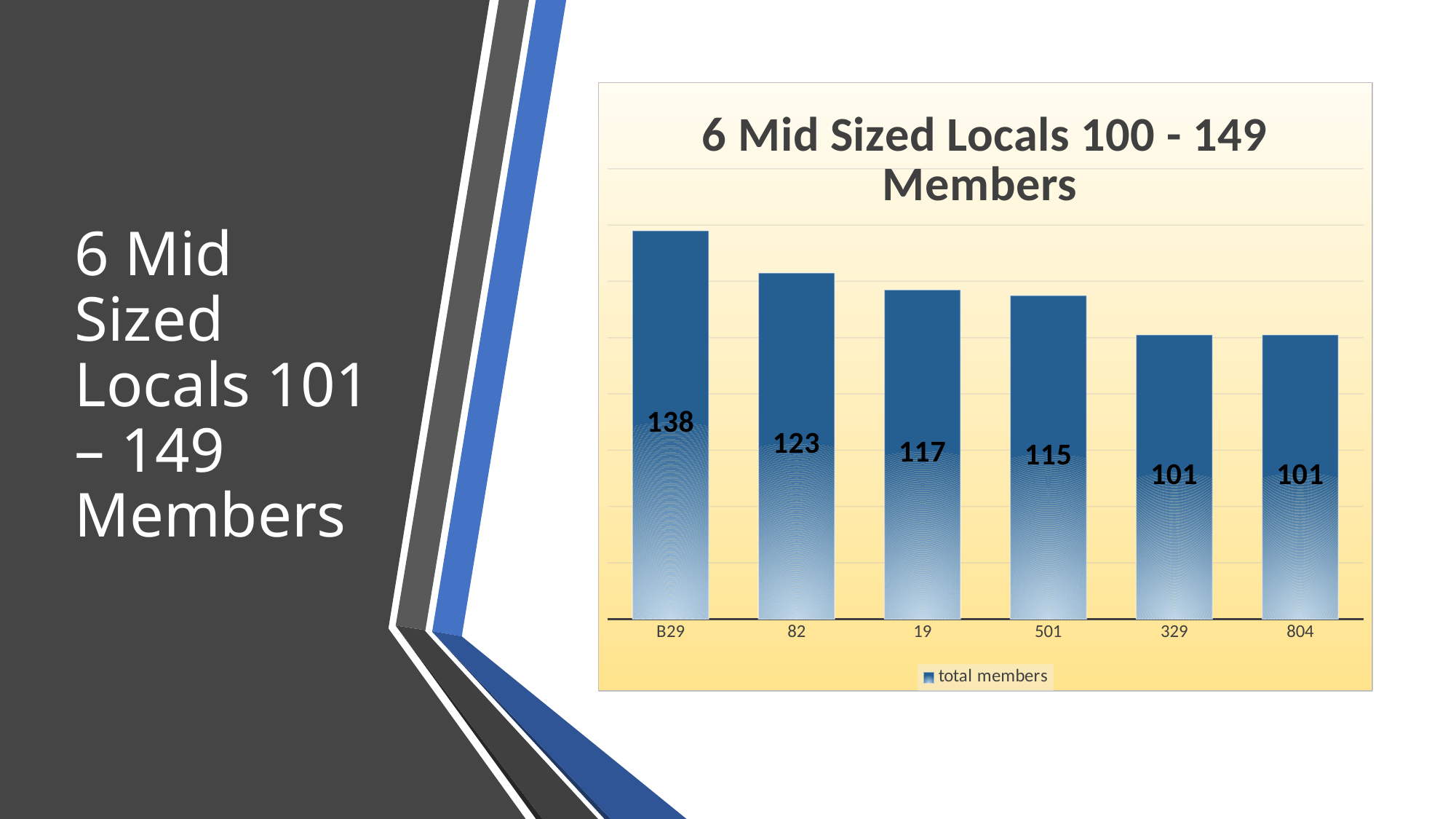
Which local has the highest total members? B29 How many locals are shown in the chart? 6 What is the total members value for local 19? 117 What is the total members value for local 329? 101 What kind of chart is shown on the slide? Bar chart Which has more total members, local 82 or local 501? 82 What is the title of the chart? 6 Mid Sized Locals 100 - 149 Members What is the difference in total members between local 19 and local 804? 16 What is the total members value for local 501? 115 What is the total members value for local B29? 138 What is the difference in total members between local B29 and local 82? 15 What is the total members value for local 82? 123